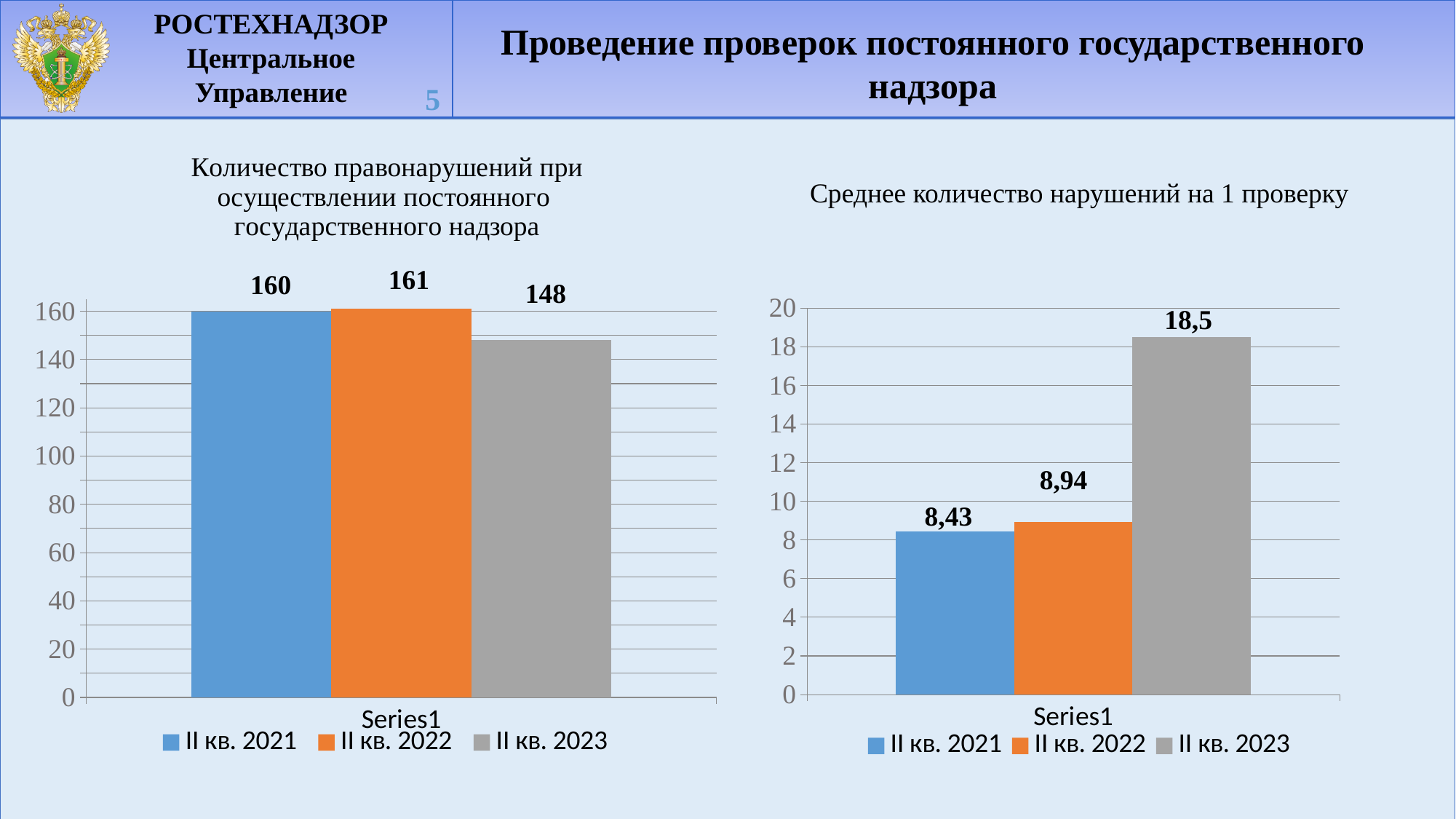
In the right chart (Среднее количество нарушений на 1 проверку), which is larger: the value for II кв. 2021 or II кв. 2023? II кв. 2023 In the right chart (Среднее количество нарушений на 1 проверку), what colour is the bar for II кв. 2022? Orange In the right chart (Среднее количество нарушений на 1 проверку), what is the value for II кв. 2021? 8,43 In the left chart (Количество правонарушений при осуществлении постоянного государственного надзора), how many series does the legend list? 3 In the right chart (Среднее количество нарушений на 1 проверку), what is the value for II кв. 2023? 18,5 In the left chart (Количество правонарушений при осуществлении постоянного государственного надзора), what is the value for II кв. 2021? 160 In the right chart (Среднее количество нарушений на 1 проверку), what is the difference between the values for II кв. 2022 and II кв. 2021? 0,51 In the left chart (Количество правонарушений при осуществлении постоянного государственного надзора), which period has the lowest value? II кв. 2023 In the right chart (Среднее количество нарушений на 1 проверку), which period has the highest value? II кв. 2023 In the left chart (Количество правонарушений при осуществлении постоянного государственного надзора), what is the value for II кв. 2023? 148 What kind of chart is the right chart (Среднее количество нарушений на 1 проверку)? Bar chart In the left chart (Количество правонарушений при осуществлении постоянного государственного надзора), what is the difference between the values for II кв. 2022 and II кв. 2023? 13